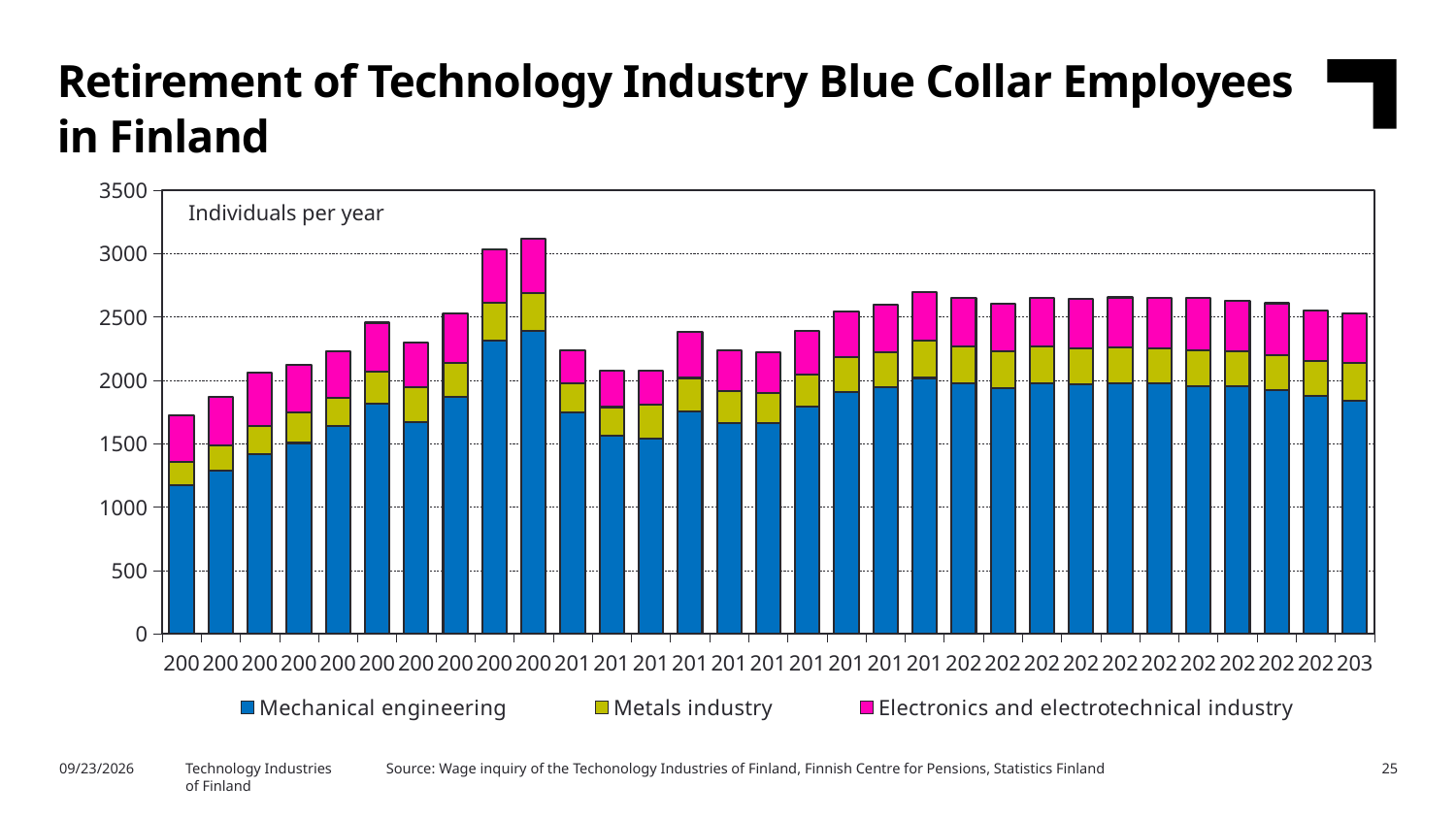
Is the total of the first (leftmost) bar greater or less than 2000? less Is the total of the tallest bar greater or less than 3000? greater Is the Mechanical engineering segment of the tallest bar greater or less than 2000? greater How many bars are plotted in the chart? 31 Which series forms the largest segment in every bar? Mechanical engineering Which series forms the smallest segment in the first (leftmost) bar? Metals industry Do the bar totals generally rise or fall across the first ten bars from left to right? rise What kind of chart is shown on the slide? Stacked bar chart What are the three series named in the legend? Mechanical engineering, Metals industry, Electronics and electrotechnical industry What unit label is shown inside the plot area? Individuals per year How many series does the legend list? 3